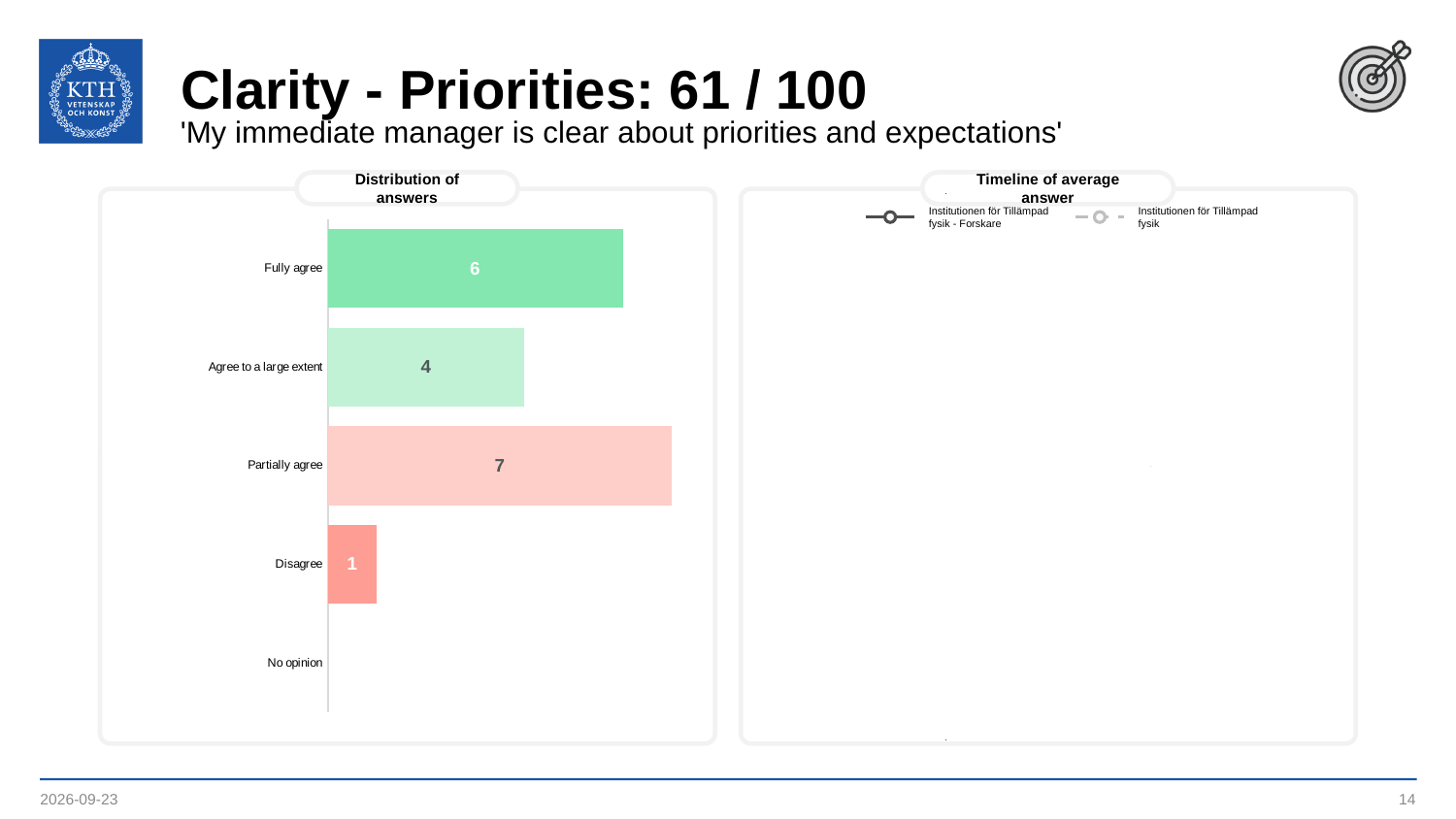
In the 'Distribution of answers' chart, what is the value for 'Partially agree'? 7 In the 'Distribution of answers' chart, what is the difference between the values for 'Fully agree' and 'Disagree'? 5 How many series does the legend of the 'Timeline of average answer' chart list? 2 In the 'Distribution of answers' chart, what is the value for 'Disagree'? 1 In the 'Distribution of answers' chart, which is larger: the value for 'Fully agree' or the value for 'Agree to a large extent'? Fully agree How many answer categories are listed on the y axis of the 'Distribution of answers' chart? 5 In the 'Distribution of answers' chart, how many respondents chose 'Fully agree'? 6 In the 'Distribution of answers' chart, what is the difference between the values for 'Partially agree' and 'Fully agree'? 1 In the 'Distribution of answers' chart, what is the value for 'Agree to a large extent'? 4 What kind of chart is the 'Distribution of answers' chart? Bar chart What colour is the 'Disagree' bar in the 'Distribution of answers' chart? Red In the 'Distribution of answers' chart, which answer category has the highest value? Partially agree